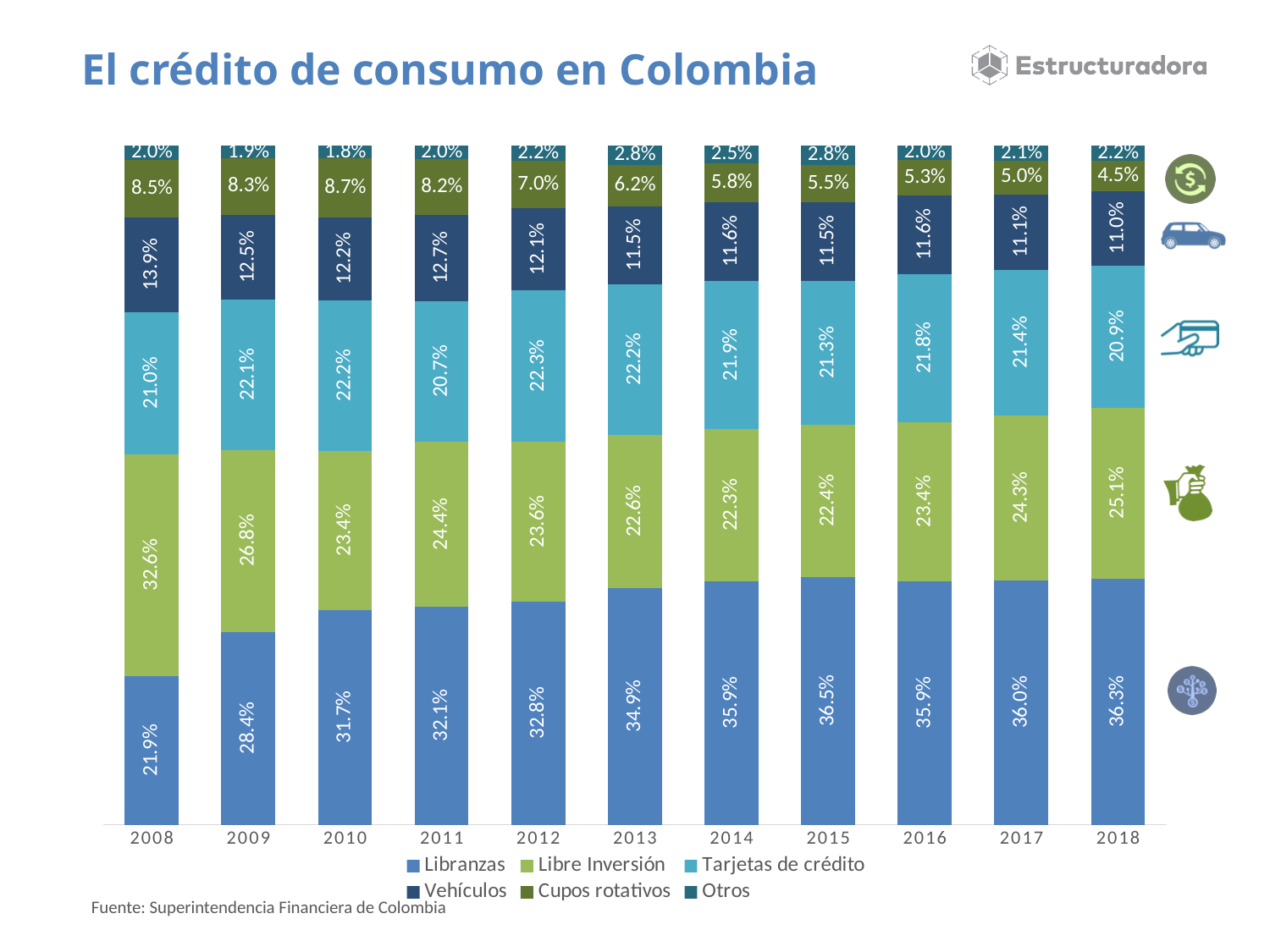
By how many percentage points did the Libranzas share change from 2008 to 2018? 14.4 percentage points What is the value for Libre Inversión in 2018? 25.1% What kind of chart is shown on the slide? Stacked bar chart In which year is the Libranzas share highest? 2015 What is the value for Cupos rotativos in 2012? 7.0% Does the Cupos rotativos share generally rise or fall from 2008 to 2018? Fall How many series does the legend list? 6 In which year is the Cupos rotativos share lowest? 2018 What is the value for Vehículos in 2008? 13.9% What is the value for Libranzas in 2008? 21.9% How many years are shown on the x axis? 11 In 2010, which is larger: Libre Inversión or Tarjetas de crédito? Libre Inversión